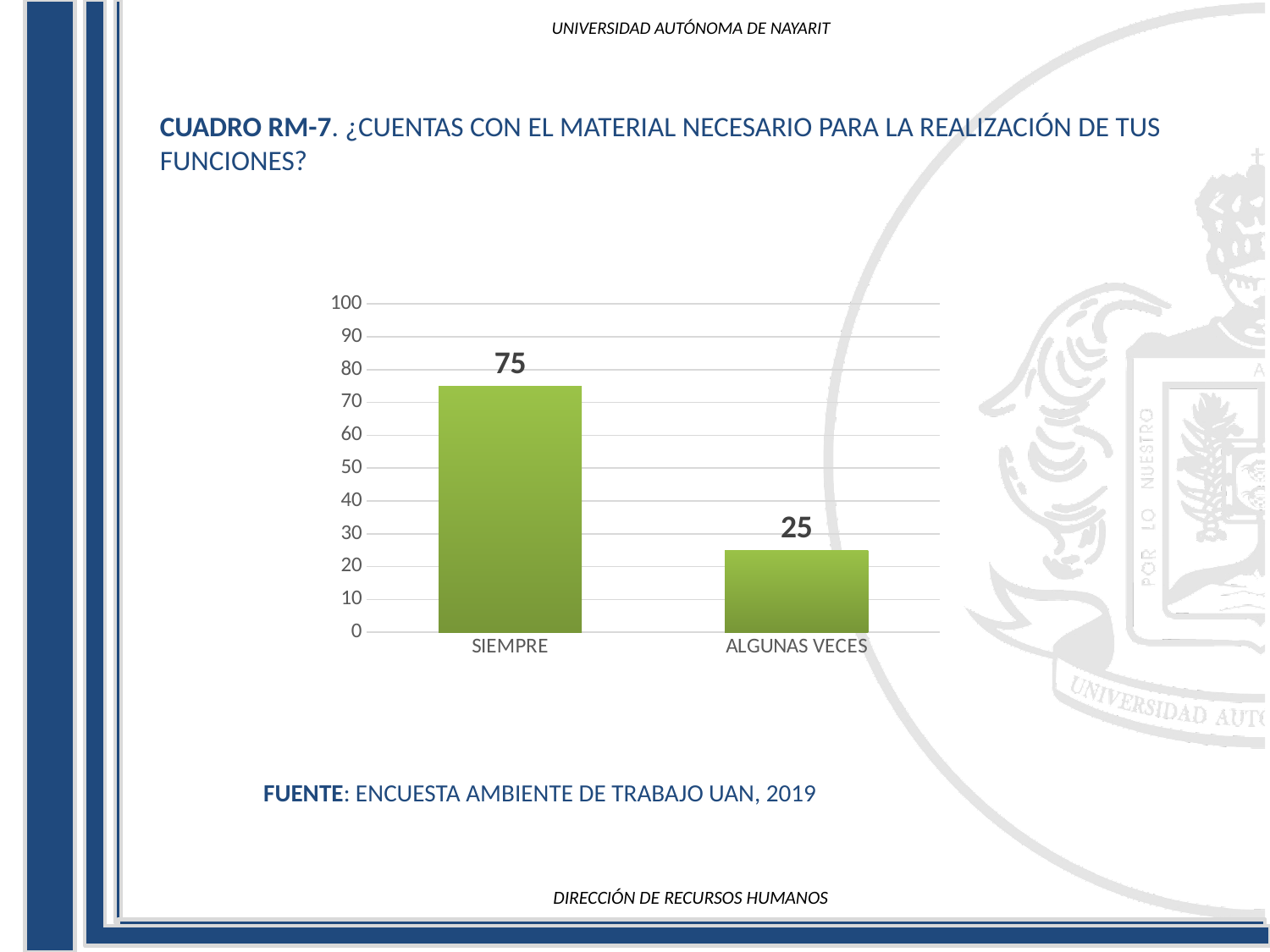
What kind of chart is shown on the slide? bar chart What colour are the bars in the chart? green Is the value for ALGUNAS VECES greater or less than 30? less Which category has the lowest value? ALGUNAS VECES Which category has the highest value? SIEMPRE Which is larger, the value for SIEMPRE or the value for ALGUNAS VECES? SIEMPRE What is the value for SIEMPRE? 75 What is the difference between the values for SIEMPRE and ALGUNAS VECES? 50 What is the maximum value shown on the vertical axis? 100 How many categories are shown on the x axis? 2 What is the value for ALGUNAS VECES? 25 Is the value for SIEMPRE greater or less than 50? greater